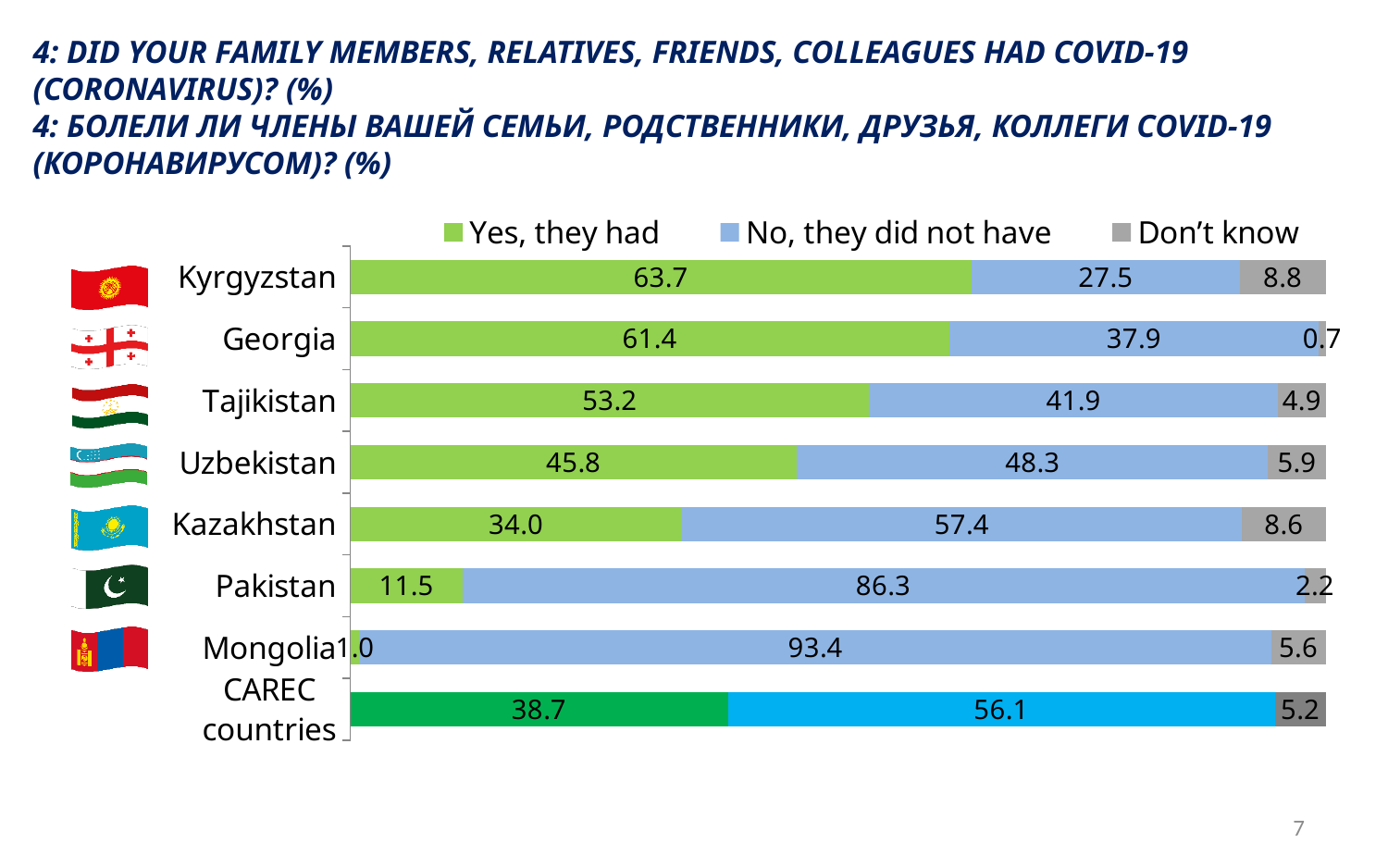
Which country has the highest "No, they did not have" value? Mongolia What is the difference between the "Yes, they had" values for Tajikistan and Uzbekistan? 7.4 What type of chart is shown on the slide? Stacked bar chart How many series does the legend list? 3 What percentage of respondents in Kyrgyzstan said "Yes, they had"? 63.7 Which is larger for Kazakhstan: "Yes, they had" or "No, they did not have"? No, they did not have Which country has the lowest "Yes, they had" value? Mongolia What is the "No, they did not have" value for Pakistan? 86.3 Which country has the highest "Yes, they had" value? Kyrgyzstan How many categories (countries/groups) are shown on the chart? 8 What is the "Yes, they had" value for CAREC countries? 38.7 What is the "Don't know" value for Georgia? 0.7